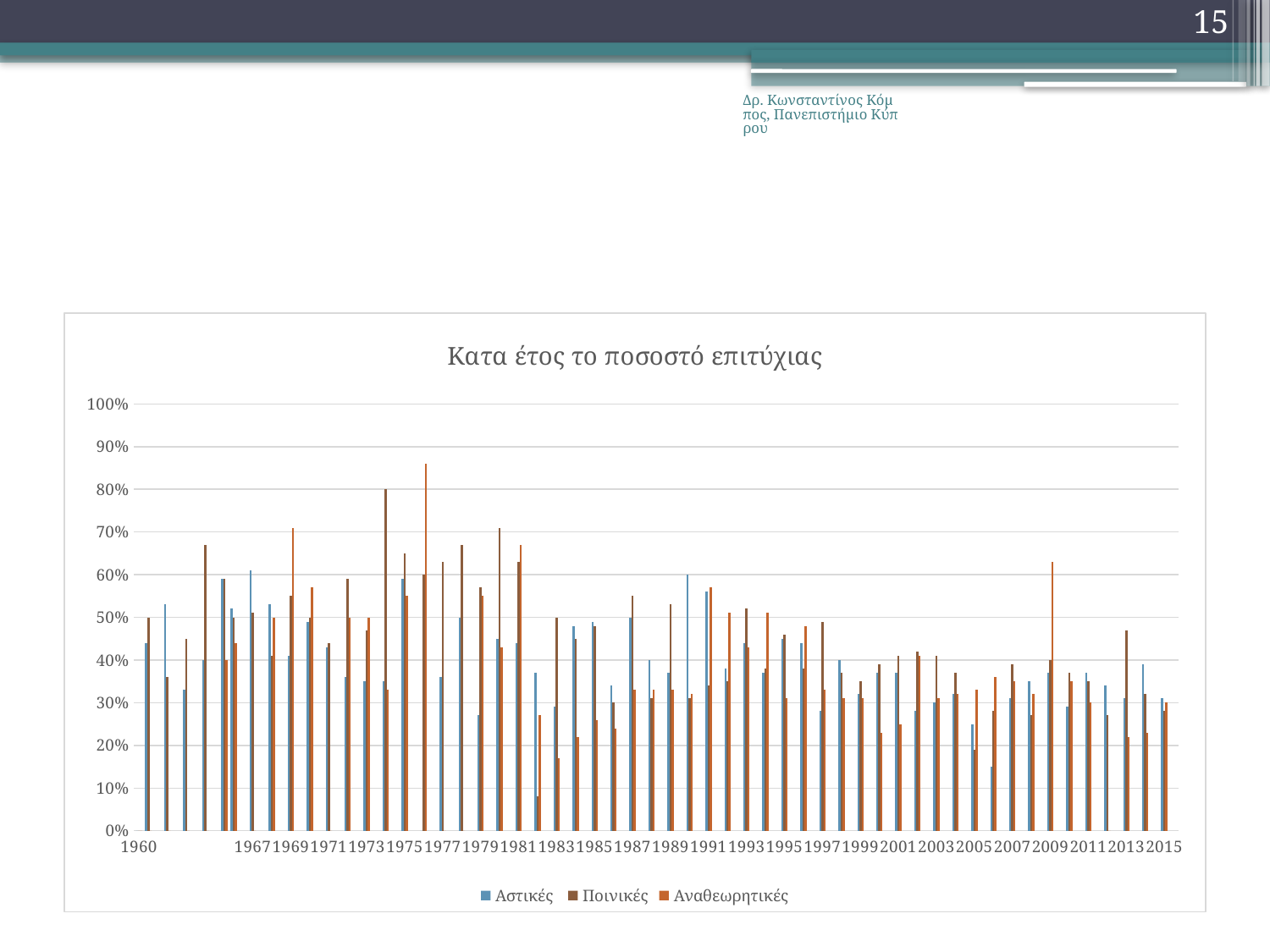
What is the highest value shown on the y axis? 100% Which series is shown in blue in the legend? Αστικές Is the value for Αστικές in 1960 greater or less than 50%? less What is the last year label on the x axis? 2015 Is the tallest bar in the chart greater or less than 80%? greater What kind of chart is shown on the slide? bar chart Which series contains the single tallest bar in the chart? Αναθεωρητικές What is the title of the chart? Κατα έτος το ποσοστό επιτύχιας Is the value for Αναθεωρητικές in 2009 greater or less than 50%? greater What is the first year label on the x axis? 1960 How many series does the legend list? 3